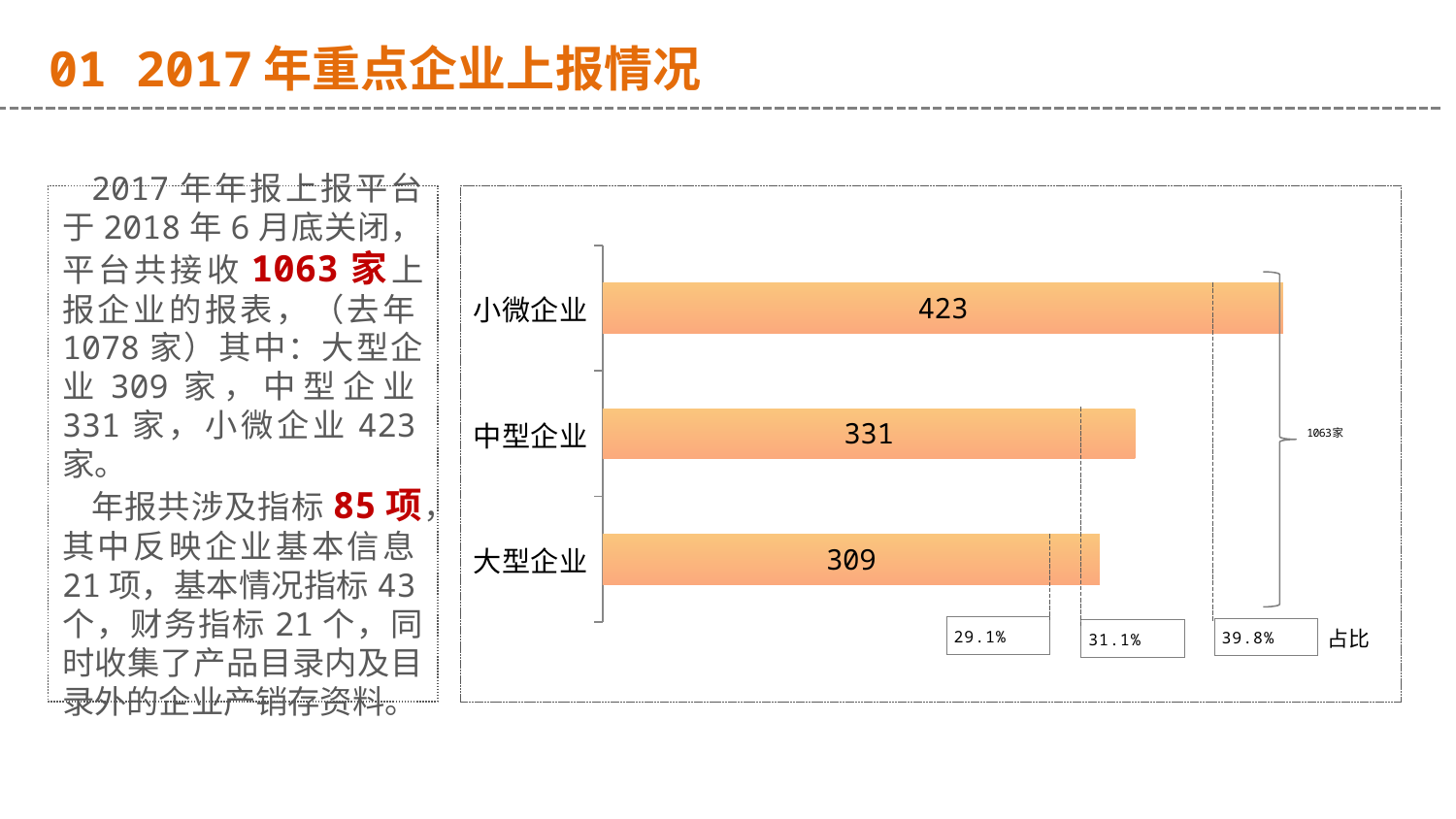
What is the difference between the values for 中型企业 and 大型企业? 22 What is the total of the three bar values shown in the chart? 1063 What is the value for 中型企业? 331 What kind of chart is shown on the slide? bar chart What is the value for 大型企业? 309 How many categories are shown in the chart? 3 What percentage share (占比) is shown for 小微企业? 39.8% Which category has the lowest value? 大型企业 Which is larger, the value for 中型企业 or the value for 大型企业? 中型企业 What is the value for 小微企业? 423 What is the difference between the values for 小微企业 and 大型企业? 114 Which category has the highest value? 小微企业